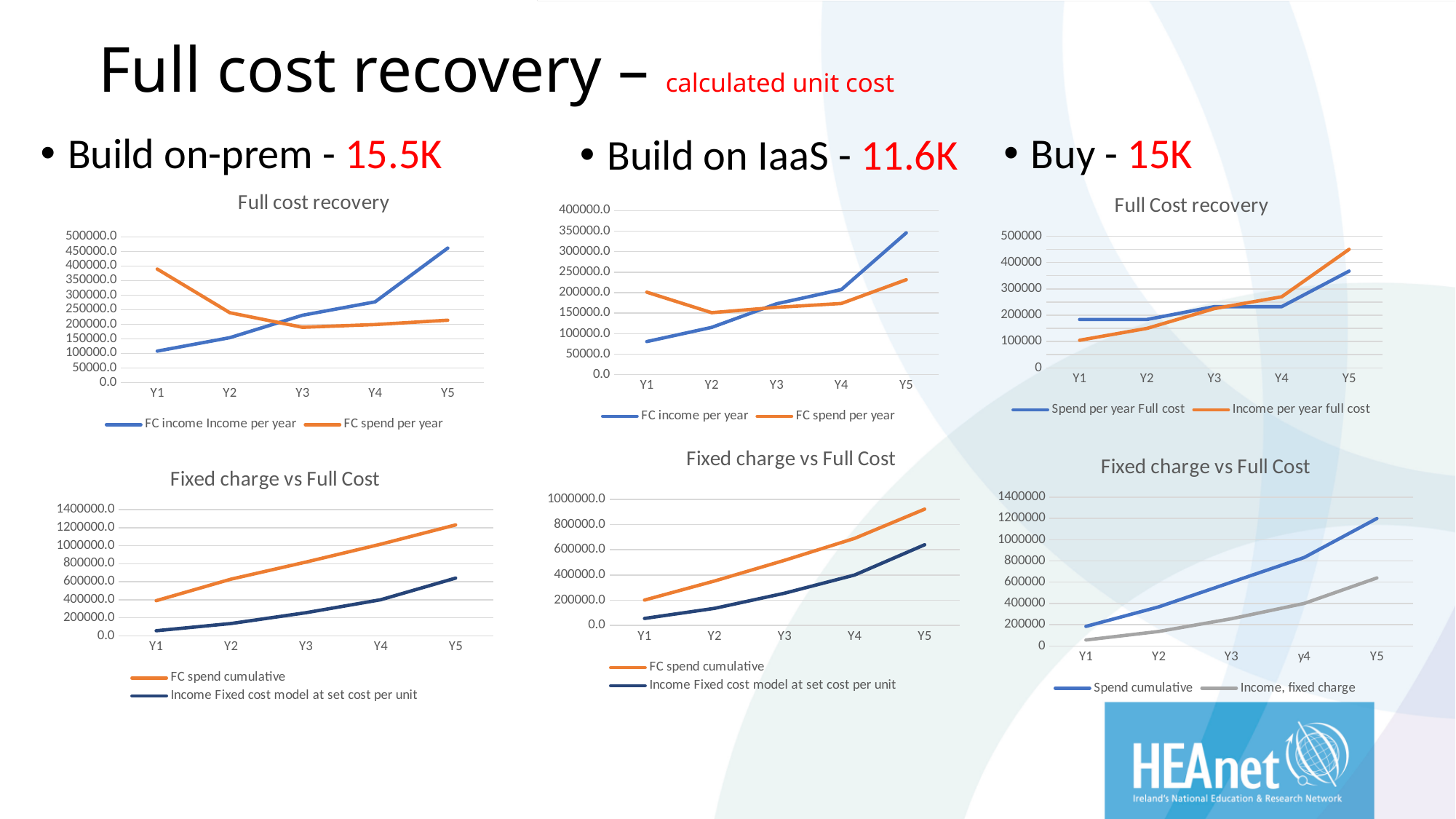
In the top-right chart titled 'Full Cost recovery' under 'Buy', which series is higher at Y5, 'Spend per year Full cost' or 'Income per year full cost'? Income per year full cost In the top-left chart titled 'Full cost recovery' under 'Build on-prem', does 'FC spend per year' rise or fall from Y1 to Y3? fall In the bottom-middle chart titled 'Fixed charge vs Full Cost' under 'Build on IaaS', does 'FC spend cumulative' rise or fall from Y1 to Y5? rise In the bottom-right chart titled 'Fixed charge vs Full Cost' under 'Buy', what are the two legend entries? Spend cumulative; Income, fixed charge In the top-right chart titled 'Full Cost recovery' under 'Buy', how many x-axis categories are plotted? 5 In the top-left chart titled 'Full cost recovery' under 'Build on-prem', is the value of 'FC income Income per year' at Y5 greater or less than 400000.0? greater In the bottom-right chart titled 'Fixed charge vs Full Cost' under 'Buy', is the value of 'Income, fixed charge' at Y5 greater or less than 800000? less In the top-middle chart under 'Build on IaaS', which series is higher at Y5, 'FC income per year' or 'FC spend per year'? FC income per year In the top-left chart titled 'Full cost recovery' under 'Build on-prem', what kind of chart is it? line chart In the top-middle chart under 'Build on IaaS', is the value of 'FC income per year' at Y1 greater or less than 100000.0? less In the top-left chart titled 'Full cost recovery' under 'Build on-prem', how many series does the legend list? 2